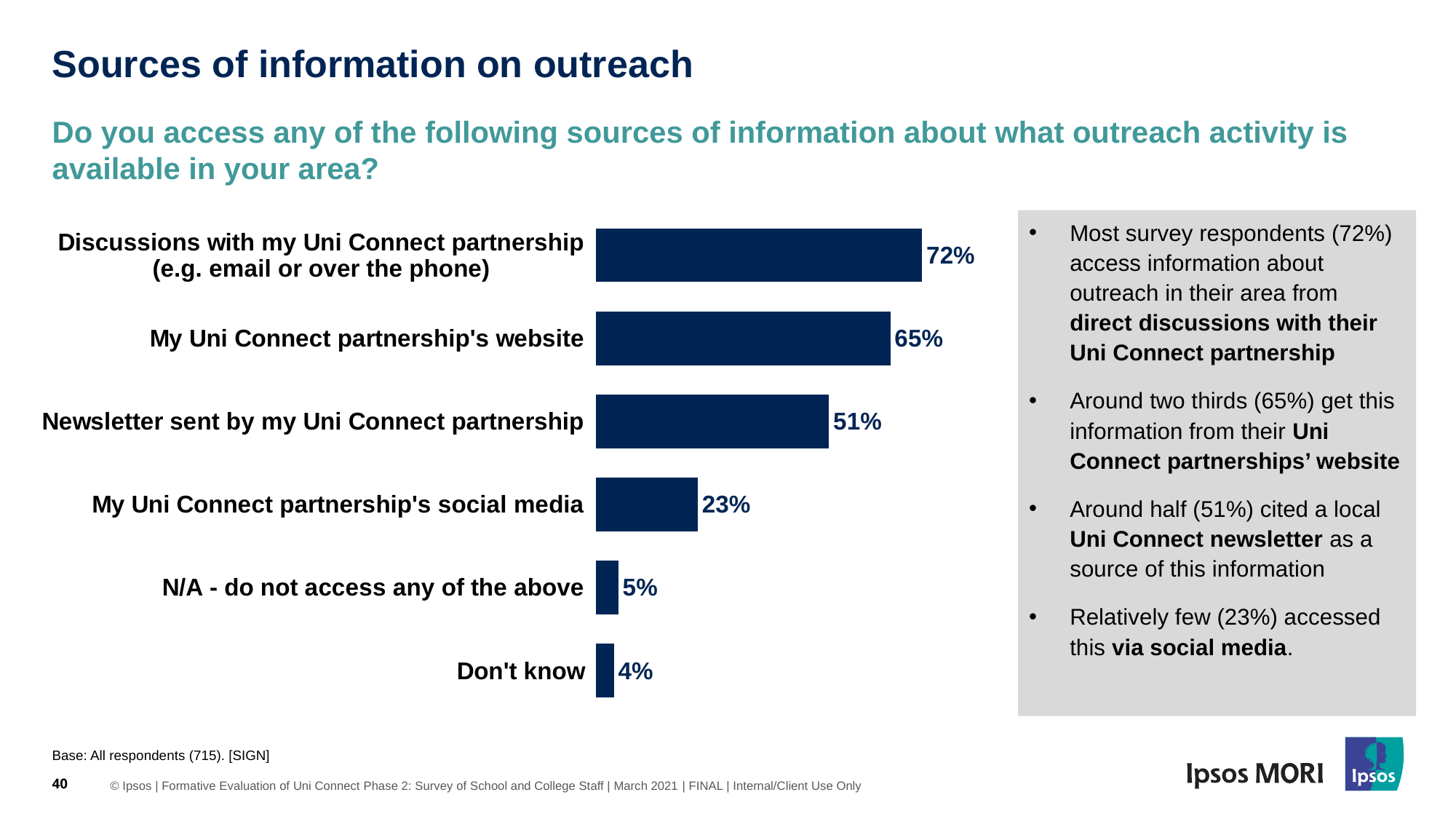
Which is larger: the value for 'N/A - do not access any of the above' or the value for 'Don't know'? N/A - do not access any of the above What type of chart is shown on the slide? Bar chart Which source of information has the highest percentage? Discussions with my Uni Connect partnership (e.g. email or over the phone) What percentage of respondents use the newsletter sent by their Uni Connect partnership? 51% What is the value shown for 'My Uni Connect partnership's website'? 65% What is the value for 'Don't know'? 4% What is the base size stated for the chart? All respondents (715) Which category has the lowest value in the chart? Don't know How many categories are shown in the chart? 6 What is the difference between the values for discussions with the partnership and the newsletter? 21 What percentage of respondents access information through discussions with their Uni Connect partnership? 72% What is the difference in percentage points between the website and social media categories? 42